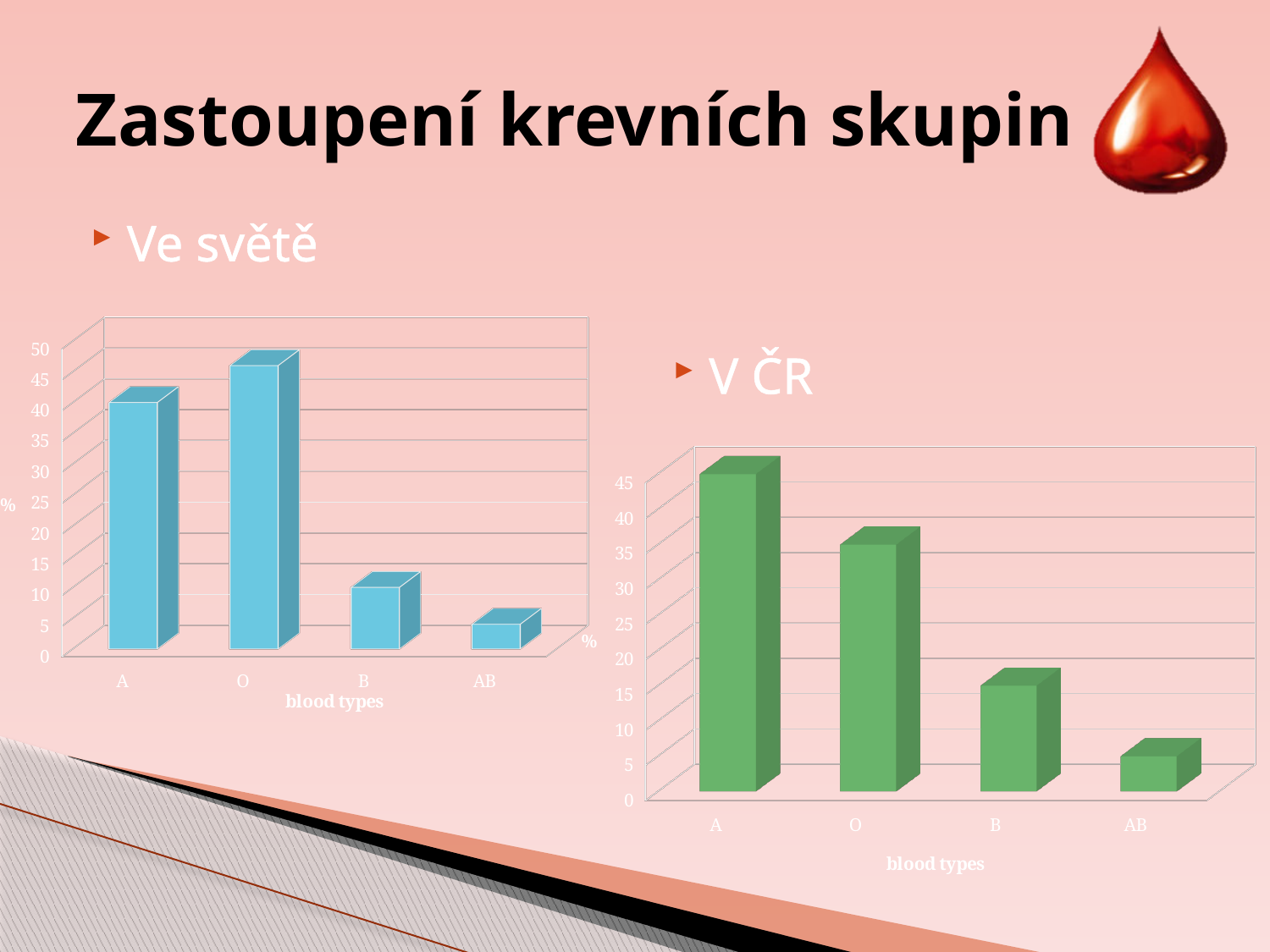
In the "V ČR" chart, is the value for O greater or less than 30? greater In the "V ČR" chart, which blood type has the highest value? A In the "Ve světě" chart, is the value for A greater or less than 30? greater What is the x-axis title of the "V ČR" chart? blood types In the "V ČR" chart, which blood type has the lowest value? AB In the "V ČR" chart, is the value for B greater or less than 25? less In the "Ve světě" chart, which blood type has the lowest value? AB In the "Ve světě" chart, which is larger, the value for A or the value for B? A How many blood type categories does the "Ve světě" chart show? 4 In the "Ve světě" chart, which blood type has the highest value? O What kind of chart is the "Ve světě" chart on the left? bar chart